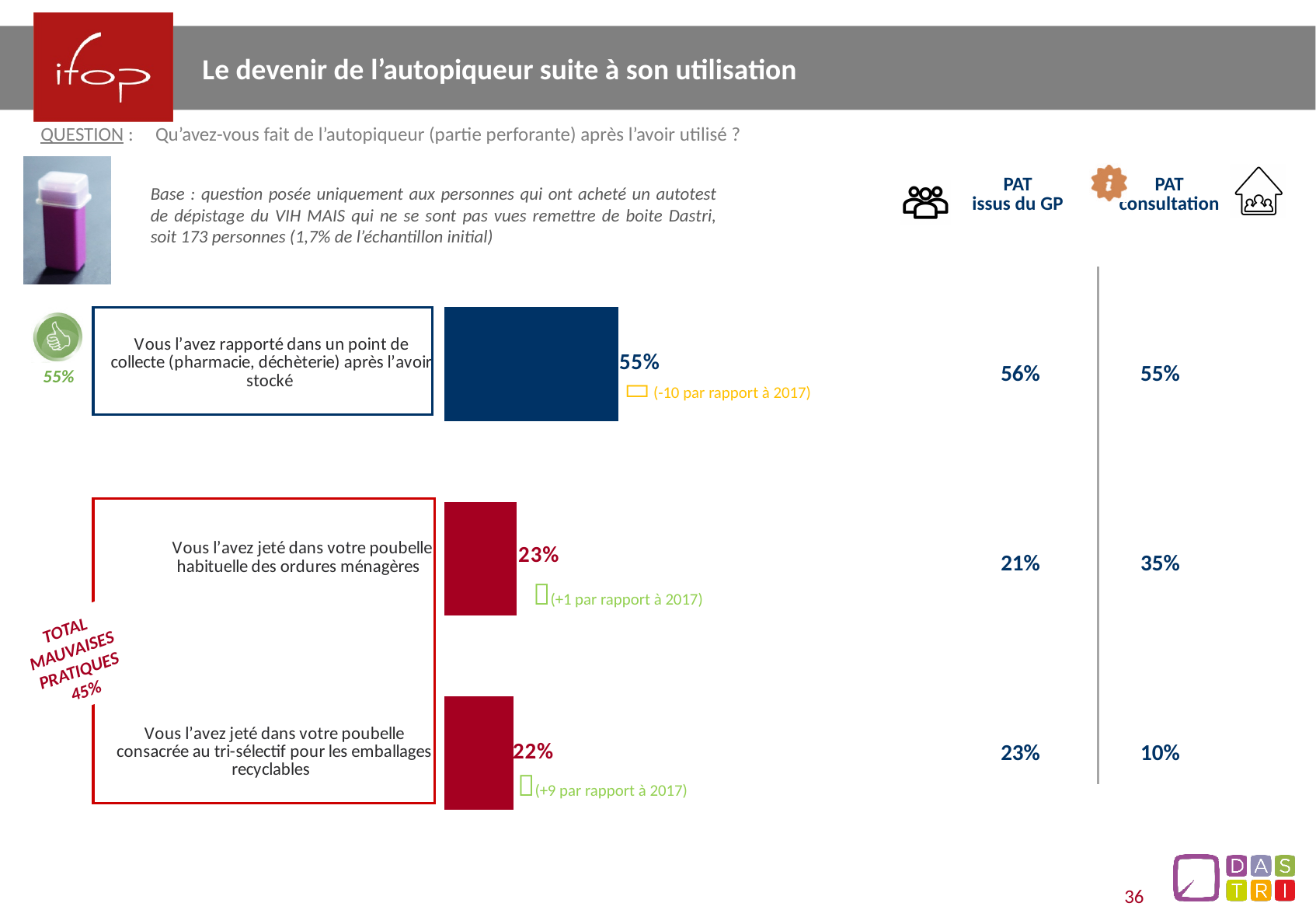
In the 'PAT issus du GP' column, what percentage brought the device to a collection point? 56% What percentage of respondents threw the lancing device into their recycling bin for packaging? 22% What is the total for 'mauvaises pratiques' (bad practices) shown on the slide? 45% In the 'PAT consultation' column, what percentage threw the device into the household waste bin? 35% What percentage of respondents threw the lancing device into their usual household waste bin? 23% What percentage of respondents said they brought the lancing device to a collection point (pharmacy, waste centre) after storing it? 55% Which response category has the lowest percentage in the bar chart? Vous l'avez jeté dans votre poubelle consacrée au tri-sélectif pour les emballages recyclables What is the difference in percentage points between bringing the device to a collection point (55%) and throwing it in the household waste bin (23%)? 32 What is the change compared to 2017 for the 'point de collecte' response? -10 Which response category has the highest percentage in the bar chart? Vous l'avez rapporté dans un point de collecte (pharmacie, déchèterie) après l'avoir stocké What type of chart is used to show the responses? Bar chart How many response categories are shown in the bar chart? 3